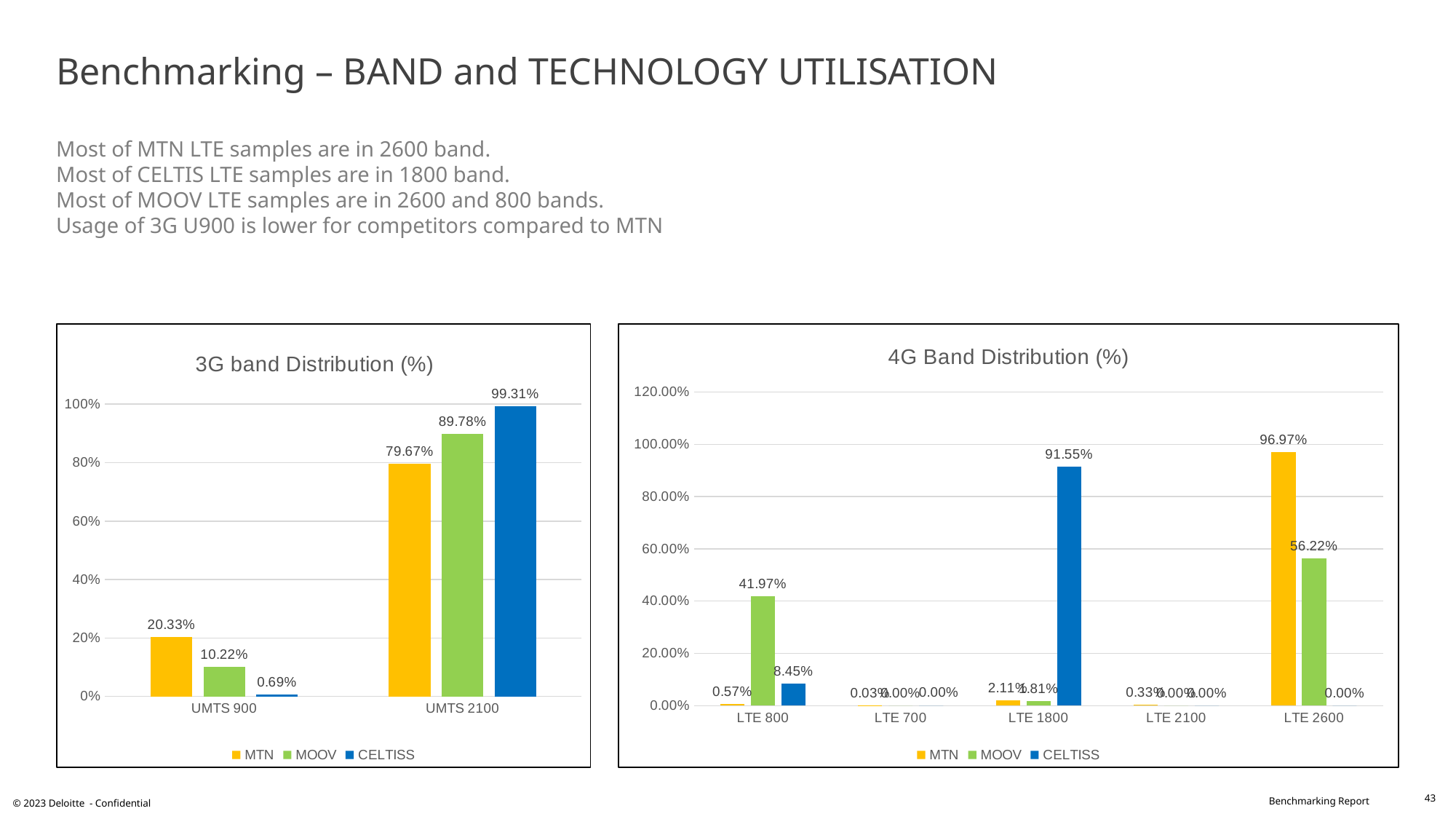
In the 4G Band Distribution (%) chart, what is the value for CELTISS in LTE 1800? 91.55% In the 4G Band Distribution (%) chart, which operator has the highest value in LTE 2600? MTN In the 3G band Distribution (%) chart, what is the value for MTN in UMTS 900? 20.33% What kind of chart is the 4G Band Distribution (%) chart? Bar chart In the 4G Band Distribution (%) chart, what is the difference between MTN and MOOV in LTE 2600? 40.75% In the 3G band Distribution (%) chart, what is the difference between MTN and MOOV in UMTS 900? 10.11% In the 3G band Distribution (%) chart, what is the value for CELTISS in UMTS 2100? 99.31% In the 3G band Distribution (%) chart, which operator has the lowest value in UMTS 900? CELTISS In the 4G Band Distribution (%) chart, what is the value for MOOV in LTE 800? 41.97% In the 3G band Distribution (%) chart, which operator has the highest value in UMTS 2100? CELTISS In the 4G Band Distribution (%) chart, how many LTE band categories are shown on the x axis? 5 In the 3G band Distribution (%) chart, how many series does the legend list? 3